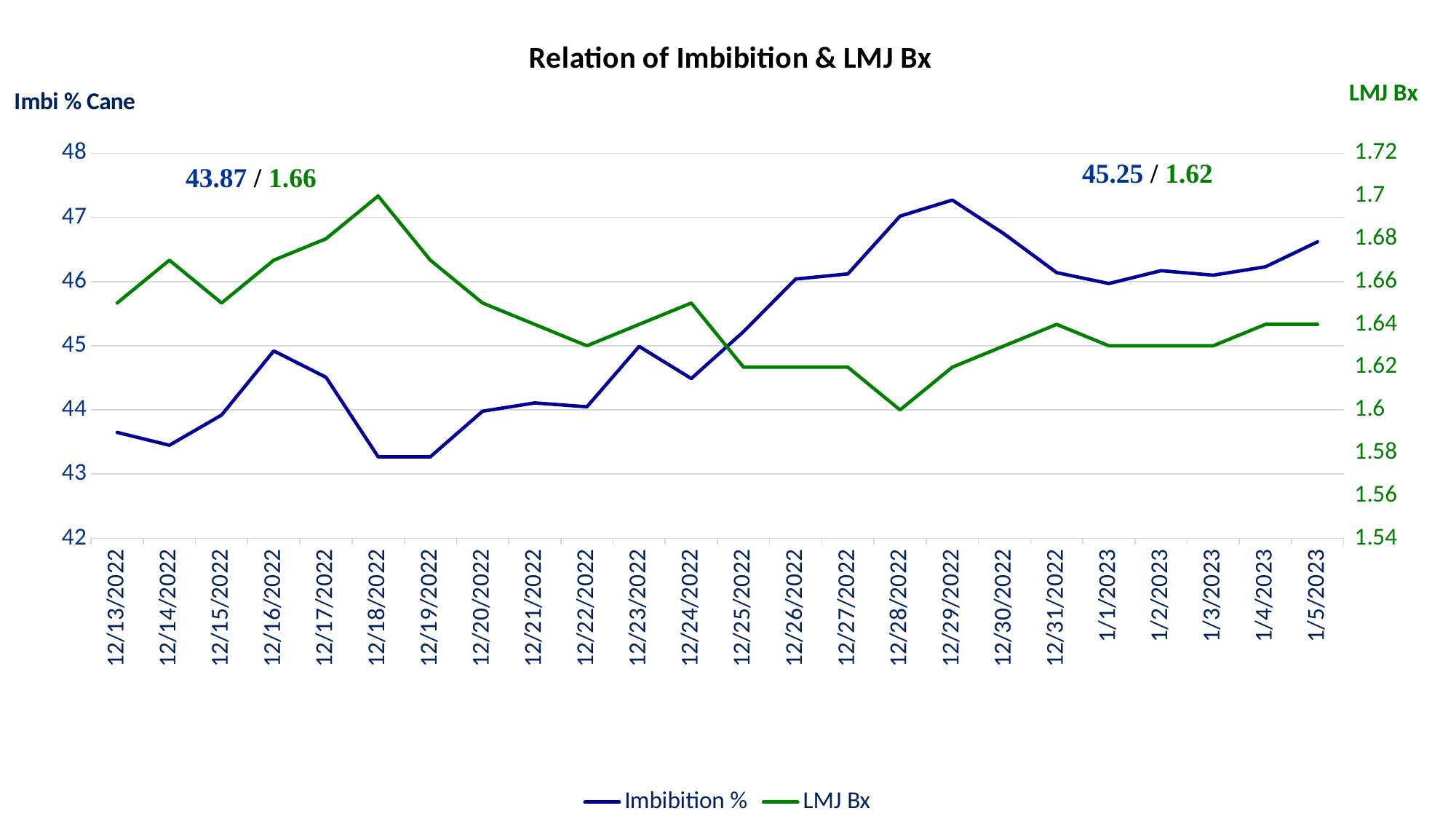
What is the title of the chart? Relation of Imbibition & LMJ Bx Which date has the higher Imbibition % value, 12/16/2022 or 12/19/2022? 12/16/2022 How many series does the legend list? 2 On which date does the LMJ Bx series reach its highest value? 12/18/2022 On which date does the LMJ Bx series reach its lowest value? 12/28/2022 Is the LMJ Bx value on 12/18/2022 greater or less than 1.68? greater How many dates are plotted along the x axis? 24 Does the Imbibition % series rise or fall between 12/24/2022 and 12/29/2022? rise On which date does the Imbibition % series reach its highest value? 12/29/2022 What type of chart is shown on the slide? Line chart Is the Imbibition % value on 12/13/2022 greater or less than 44? less Which series are listed in the legend? Imbibition % and LMJ Bx